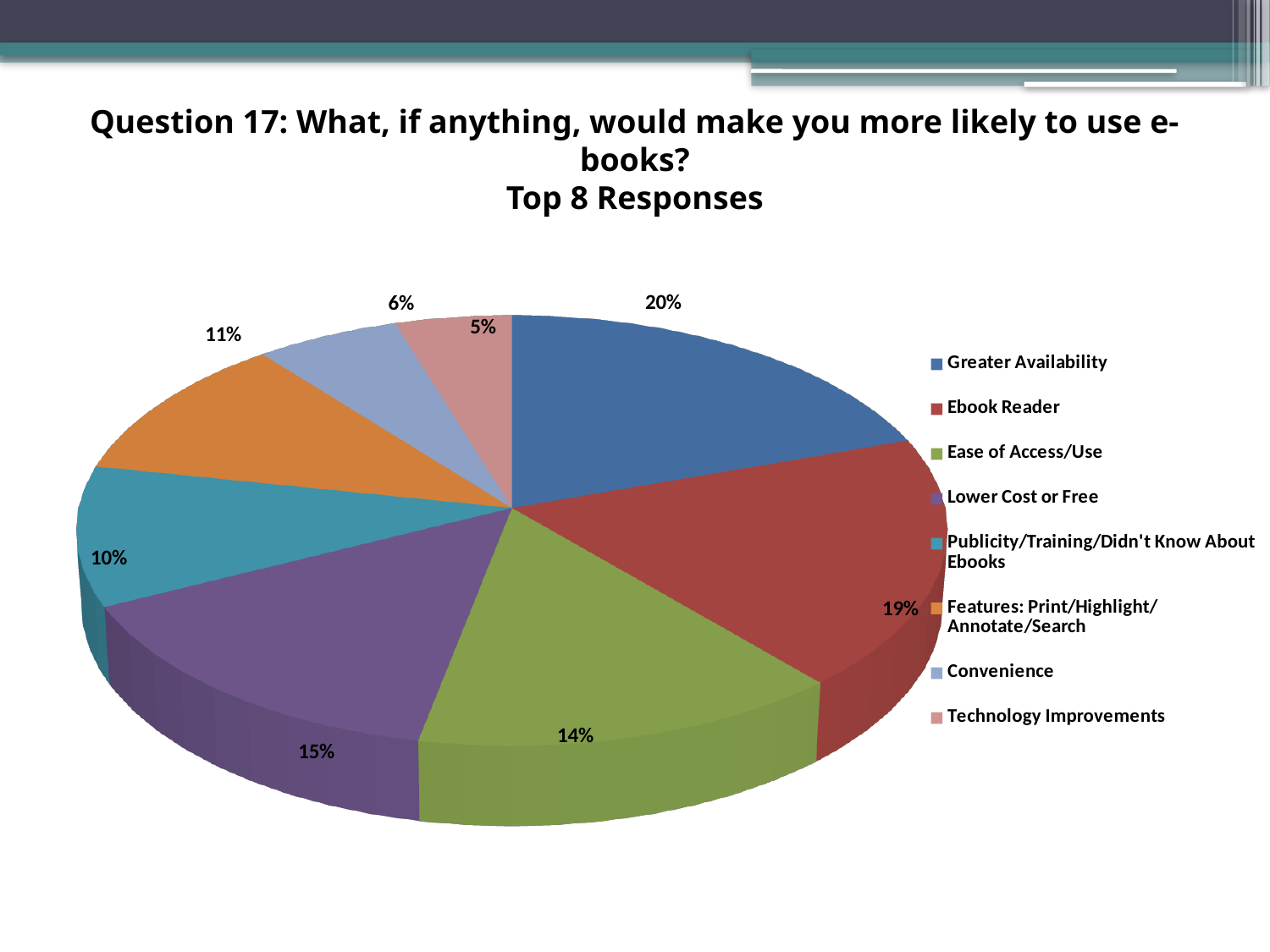
What share of responses is Publicity/Training/Didn't Know About Ebooks? 10% What share of responses is Technology Improvements? 5% Which has a larger share, Features: Print/Highlight/Annotate/Search or Convenience? Features: Print/Highlight/Annotate/Search What share of responses is Ebook Reader? 19% Which response has the smallest share of the pie? Technology Improvements How many slices does the pie chart have? 8 What share of responses is Lower Cost or Free? 15% What colour is the slice for Ease of Access/Use? green What is the difference in percentage points between Lower Cost or Free and Ease of Access/Use? 1% Which response has the largest share of the pie? Greater Availability What share of responses is Greater Availability? 20% What kind of chart is shown on the slide? pie chart